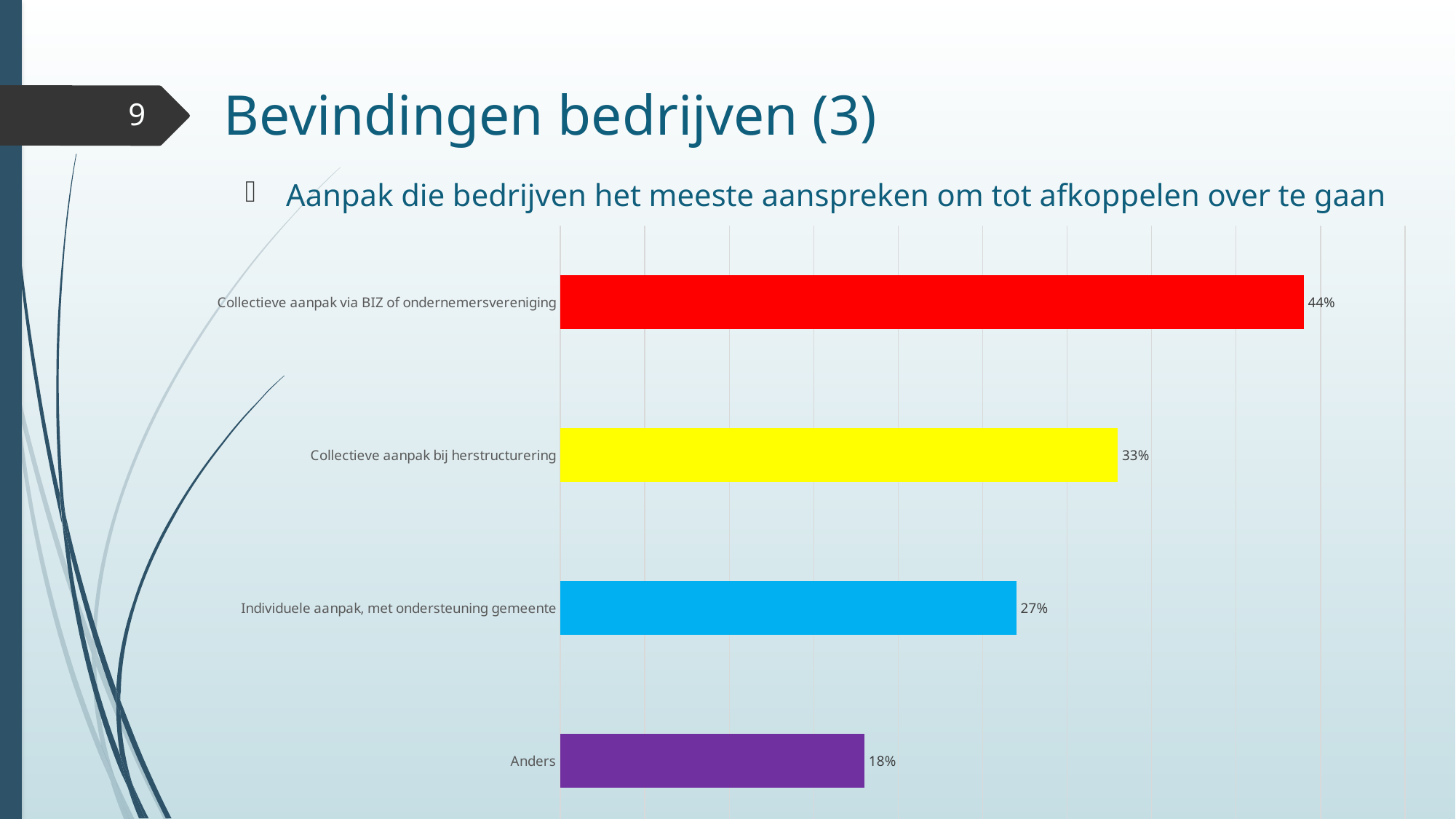
What is the value for "Individuele aanpak, met ondersteuning gemeente"? 27% What kind of chart is shown on the slide? Bar chart What is the value for "Collectieve aanpak via BIZ of ondernemersvereniging"? 44% What is the value for "Collectieve aanpak bij herstructurering"? 33% Which is larger: the value for "Collectieve aanpak bij herstructurering" or for "Individuele aanpak, met ondersteuning gemeente"? Collectieve aanpak bij herstructurering What is the difference between the values for "Collectieve aanpak via BIZ of ondernemersvereniging" and "Anders"? 26% Which category has the highest value? Collectieve aanpak via BIZ of ondernemersvereniging How many categories are shown in the chart? 4 What colour is the bar for "Anders"? Purple Which category has the lowest value? Anders What is the value for "Anders"? 18% What is the difference between the values for "Collectieve aanpak bij herstructurering" and "Individuele aanpak, met ondersteuning gemeente"? 6%